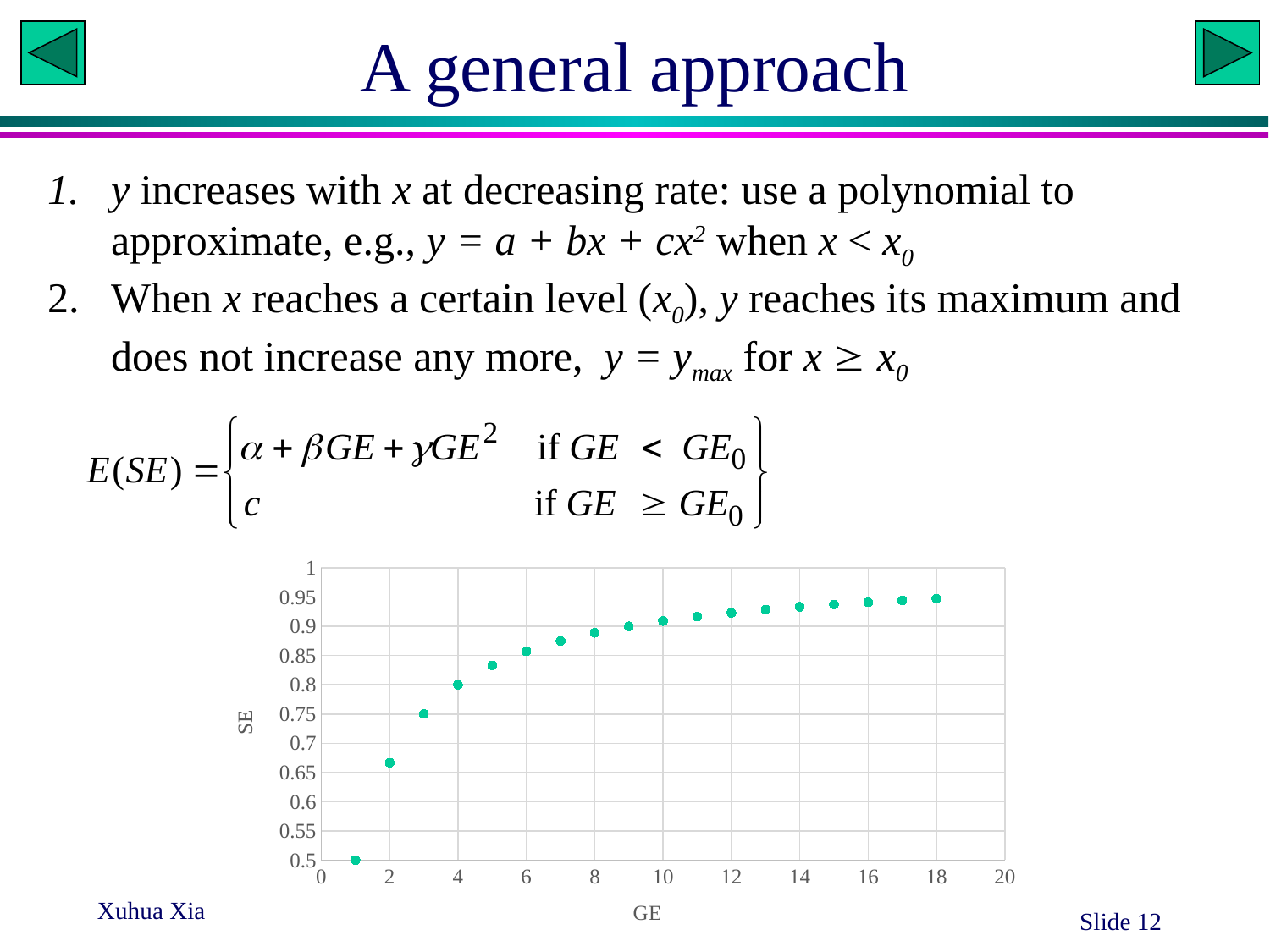
How many data points are plotted in the chart? 18 What is the label on the x axis of the chart? GE Which has the larger SE value, GE = 5 or GE = 10? GE = 10 Do the SE values rise or fall as GE increases along the x axis? rise What kind of chart is shown on the slide? scatter plot What is the label on the y axis of the chart? SE What is the SE value at GE = 1? 0.5 At which GE value is SE lowest? 1 At which GE value is SE highest? 18 Is the SE value at GE = 2 greater or less than 0.7? less